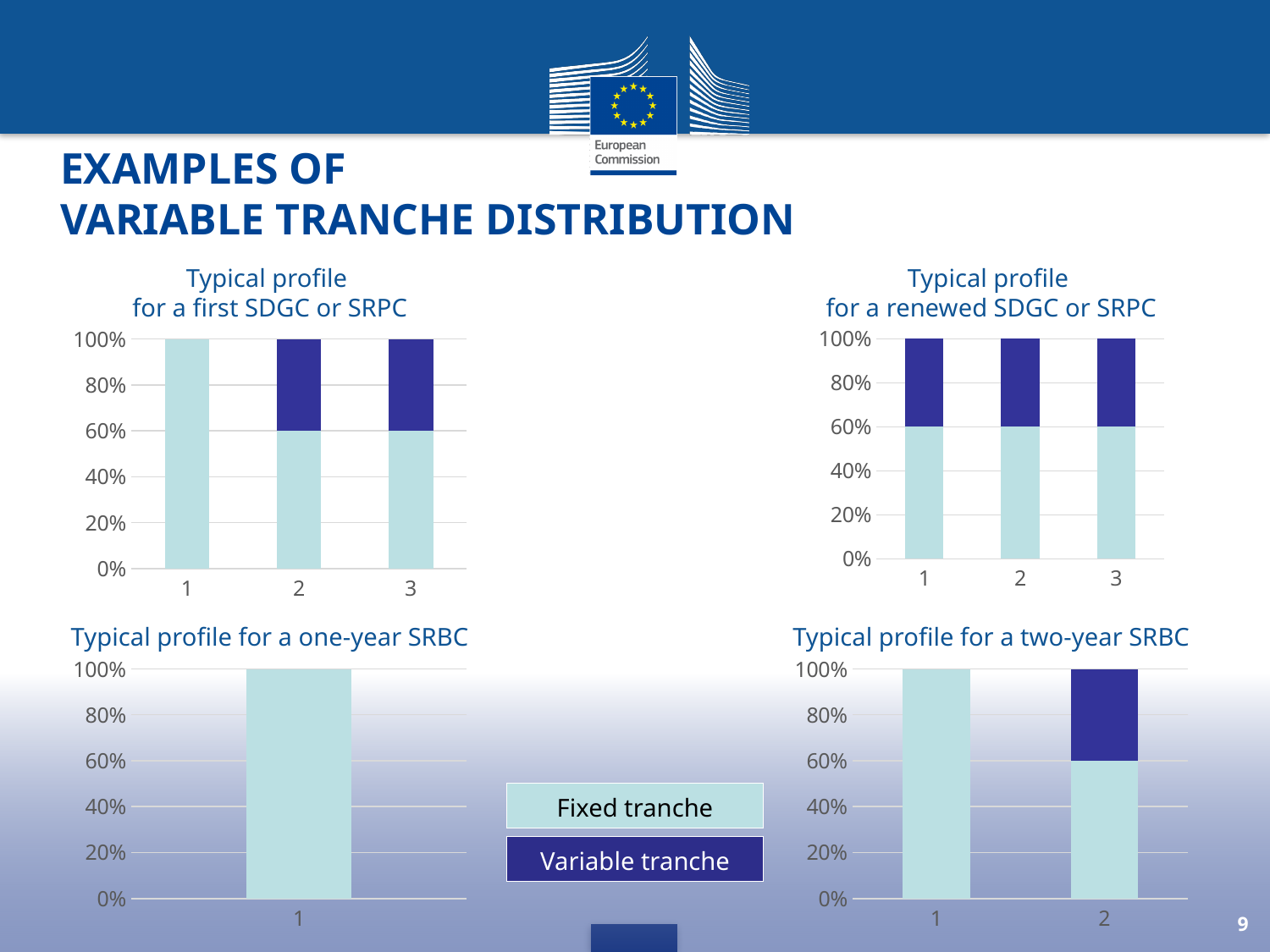
In the 'Typical profile for a first SDGC or SRPC' chart, what is the fixed tranche value for category 1? 100% In the 'Typical profile for a first SDGC or SRPC' chart, what is the fixed tranche value for category 2? 60% Which colour represents the variable tranche in the charts on this slide? Dark blue How many categories are shown on the x axis of the 'Typical profile for a first SDGC or SRPC' chart? 3 How many bars are shown in the 'Typical profile for a one-year SRBC' chart? 1 In the 'Typical profile for a first SDGC or SRPC' chart, which category has the larger fixed tranche, category 1 or category 2? Category 1 In the 'Typical profile for a renewed SDGC or SRPC' chart, is the fixed tranche value for category 1 greater or less than 80%? less How many bars are shown in the 'Typical profile for a two-year SRBC' chart? 2 How many series does the legend list for the charts on this slide? 2 In the 'Typical profile for a two-year SRBC' chart, what is the total of the stacked bar for category 2? 100% What kind of chart is the 'Typical profile for a first SDGC or SRPC' chart? Stacked bar chart In the 'Typical profile for a renewed SDGC or SRPC' chart, does the fixed tranche rise, fall or stay the same from category 1 to category 3? Stays the same